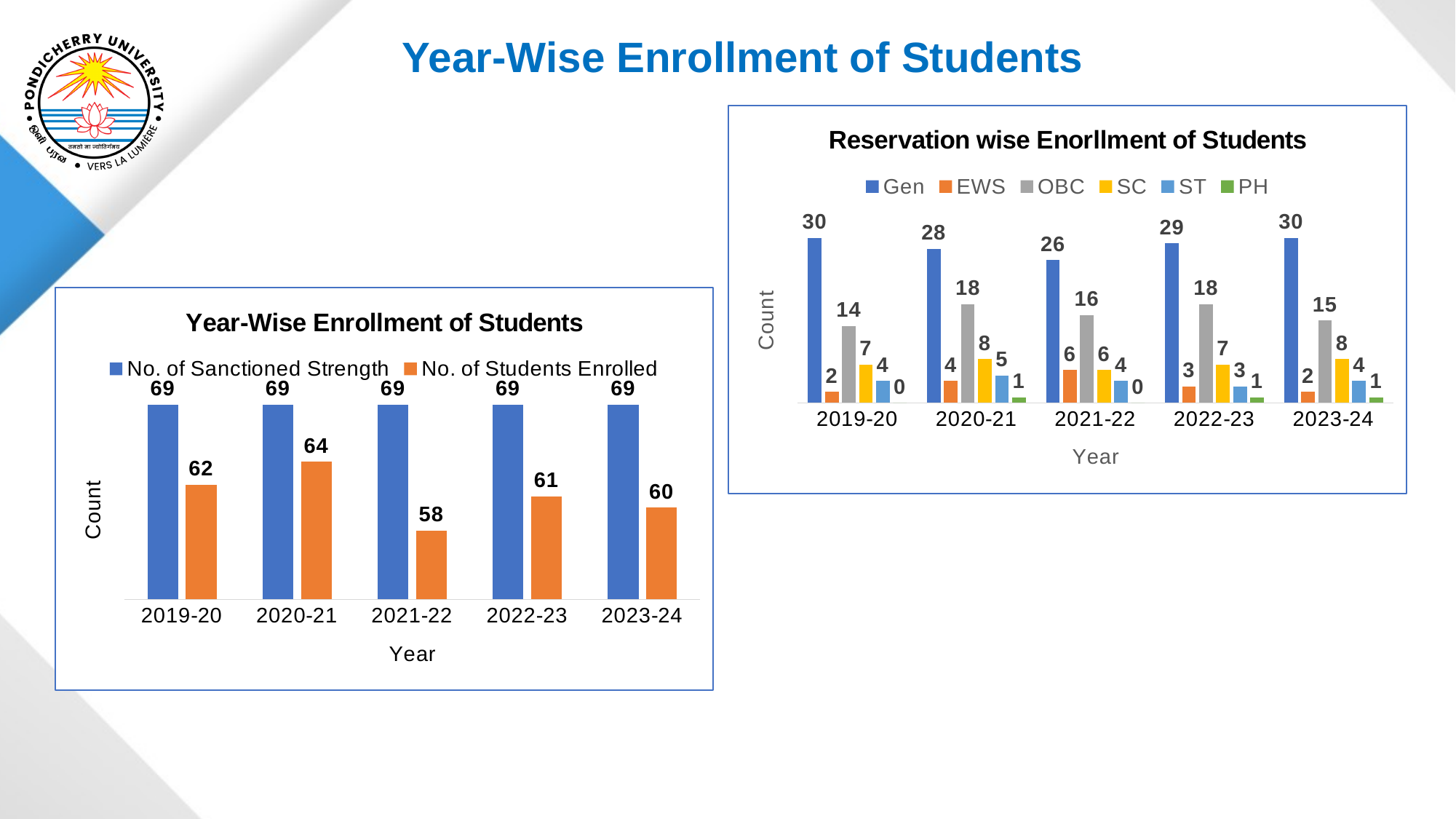
In the 'Year-Wise Enrollment of Students' chart, what is the difference between the No. of Sanctioned Strength and the No. of Students Enrolled in 2023-24? 9 In the 'Year-Wise Enrollment of Students' chart, what is the No. of Students Enrolled for 2021-22? 58 In the 'Reservation wise Enorllment of Students' chart, what is the EWS value for 2021-22? 6 In the 'Reservation wise Enorllment of Students' chart, how many series does the legend list? 6 What kind of chart is the 'Reservation wise Enorllment of Students' chart? Bar chart In the 'Year-Wise Enrollment of Students' chart, which year has the highest No. of Students Enrolled? 2020-21 In the 'Year-Wise Enrollment of Students' chart, how many years are shown on the x axis? 5 In the 'Reservation wise Enorllment of Students' chart, what is the OBC value for 2022-23? 18 In the 'Reservation wise Enorllment of Students' chart, what is the difference between the Gen value and the OBC value in 2019-20? 16 In the 'Reservation wise Enorllment of Students' chart, which year has the lowest Gen value? 2021-22 In the 'Year-Wise Enrollment of Students' chart, how many series does the legend list? 2 In the 'Reservation wise Enorllment of Students' chart, is the SC value for 2020-21 larger or the SC value for 2022-23? 2020-21